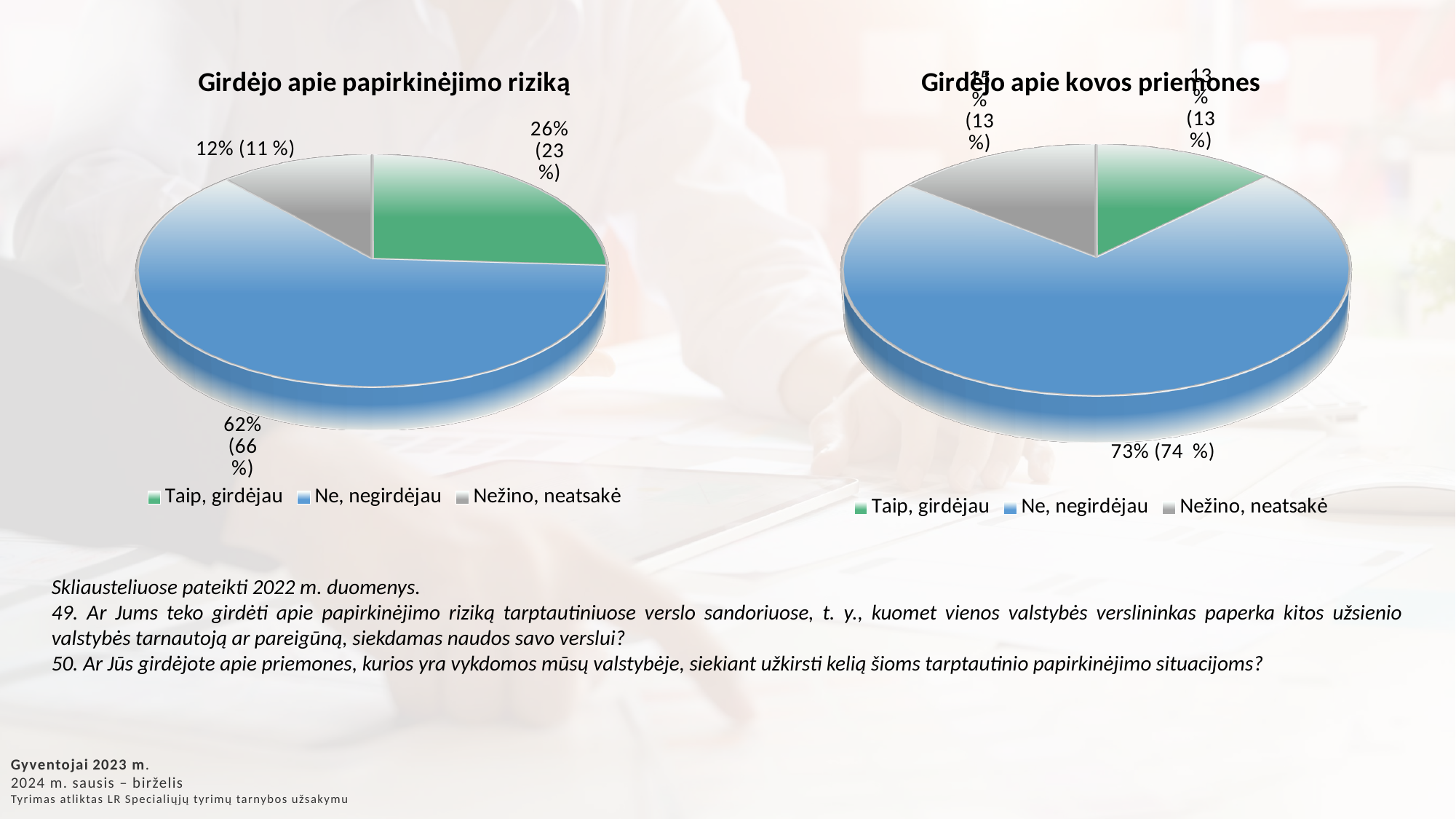
In the chart titled "Girdėjo apie papirkinėjimo riziką", what share of respondents answered "Taip, girdėjau" in 2023? 26% In the chart titled "Girdėjo apie papirkinėjimo riziką", which answer has the largest slice? Ne, negirdėjau In the chart titled "Girdėjo apie kovos priemones", what share of respondents answered "Taip, girdėjau" in 2023? 13% In the chart titled "Girdėjo apie kovos priemones", what share of respondents answered "Ne, negirdėjau" in 2023? 73% In the chart titled "Girdėjo apie papirkinėjimo riziką", which answer has the smallest slice? Nežino, neatsakė In the chart titled "Girdėjo apie papirkinėjimo riziką", what is the difference in percentage points between the 2023 shares for "Ne, negirdėjau" and "Taip, girdėjau"? 36 How many entries does the legend of the chart titled "Girdėjo apie kovos priemones" list? 3 Which is larger in 2023: the "Taip, girdėjau" share in the chart "Girdėjo apie papirkinėjimo riziką" or in the chart "Girdėjo apie kovos priemones"? Girdėjo apie papirkinėjimo riziką In the chart titled "Girdėjo apie papirkinėjimo riziką", what share of respondents answered "Ne, negirdėjau" in 2023? 62% In the chart titled "Girdėjo apie papirkinėjimo riziką", what colour is the "Ne, negirdėjau" slice? Blue What type of chart is used on this slide? Pie chart In the chart titled "Girdėjo apie papirkinėjimo riziką", what was the 2022 value (in parentheses) for "Nežino, neatsakė"? 11 %